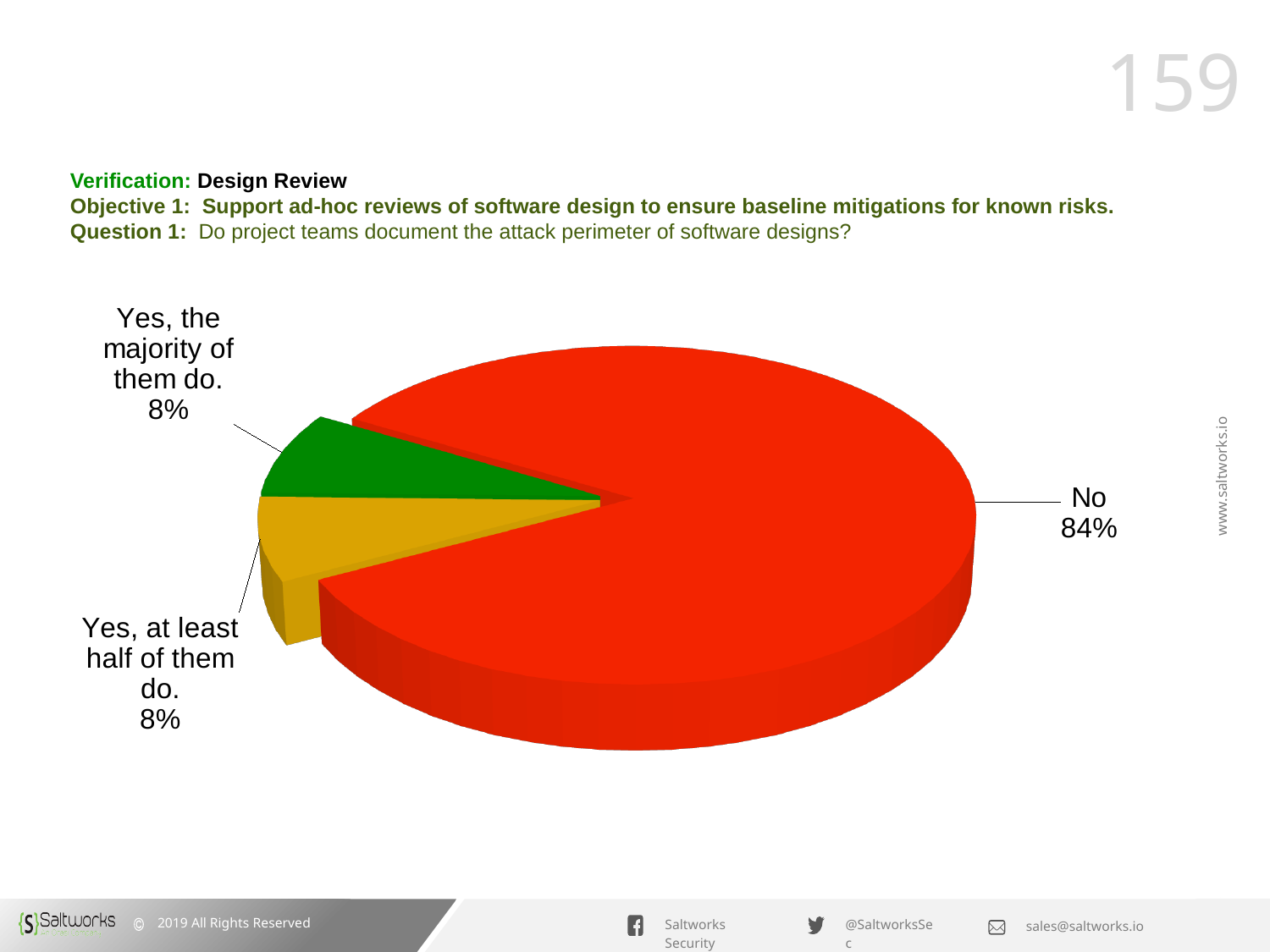
How many slices does the pie chart have? 3 What is the combined share of the two "Yes" slices? 16% What share of the pie does the "Yes, at least half of them do." slice represent? 8% Which slice of the pie is the largest? No What colour is the "No" slice? red What share of the pie does the "Yes, the majority of them do." slice represent? 8% What kind of chart is shown on the slide? pie chart Which is larger, the "No" slice or the "Yes, at least half of them do." slice? No What colour is the "Yes, the majority of them do." slice? green What is the difference between the "No" share and the "Yes, the majority of them do." share? 76% What share of the pie does the "No" slice represent? 84%